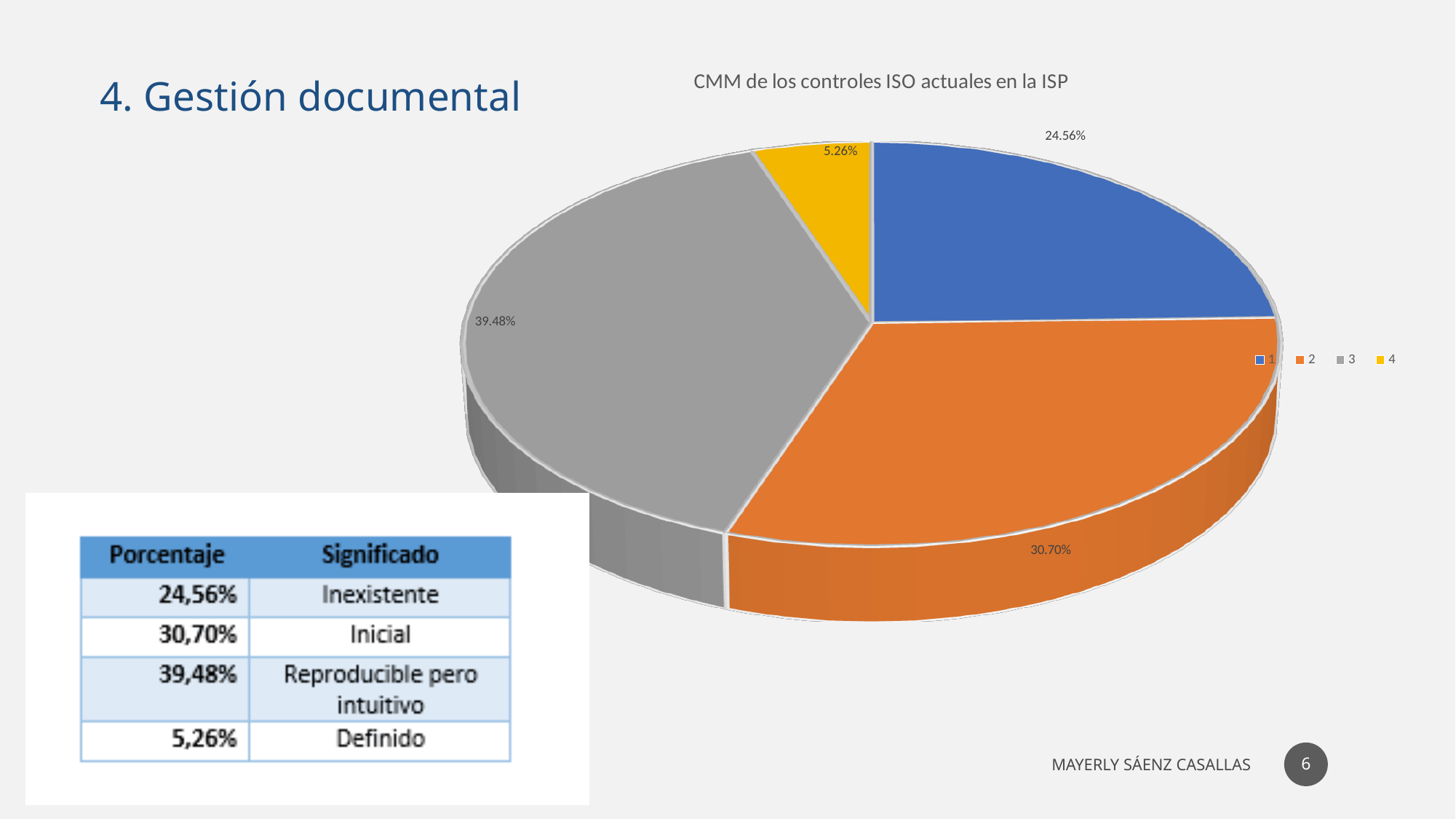
What is the difference in percentage points between category 3 and category 4? 34.22 What percentage does slice 1 represent? 24.56% What is the title of the chart? CMM de los controles ISO actuales en la ISP Which category has the smallest share of the pie? 4 What percentage does slice 2 represent? 30.70% Which category has the largest share of the pie? 3 What type of chart is shown on the slide? pie chart What percentage does slice 4 represent? 5.26% How many entries does the legend list? 4 What percentage does slice 3 represent? 39.48% How many slices does the pie chart have? 4 Which is larger, the share for category 1 or category 2? 2